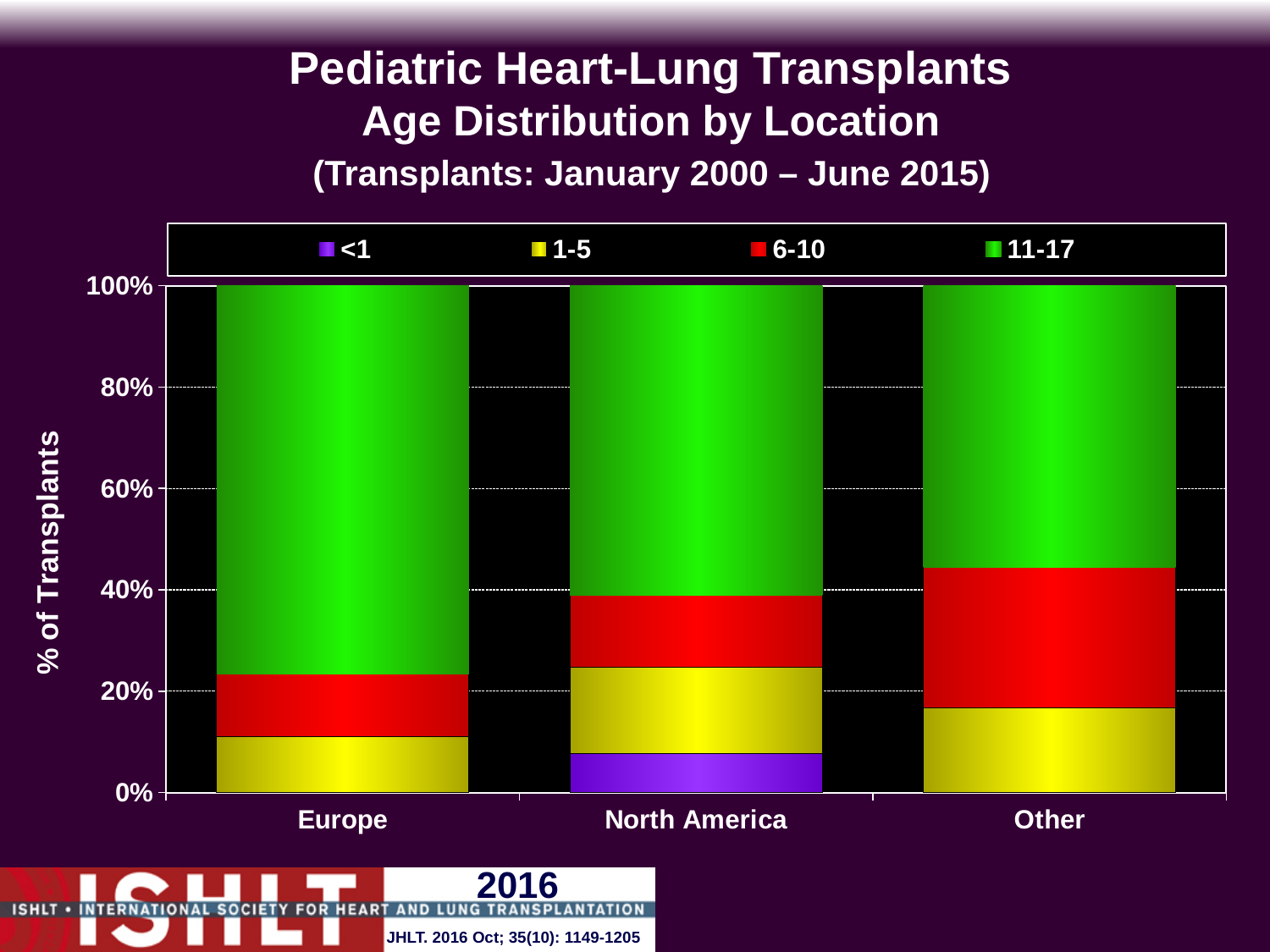
How many age groups does the legend list? 4 Is the share of the 11-17 age group larger for Europe or for Other? Europe What is the label of the y axis? % of Transplants Which location has the largest share of transplants in the 6-10 age group? Other Which location has the largest share of transplants in the 11-17 age group? Europe Is the share of the 11-17 age group for Europe greater or less than 60%? greater Which location is the only one with a visible <1 age group segment? North America Is the share of the <1 age group for North America greater or less than 20%? less Is the share of the 1-5 age group for Europe greater or less than 20%? less How many locations are shown on the x axis? 3 What kind of chart is shown on the slide? Stacked bar chart